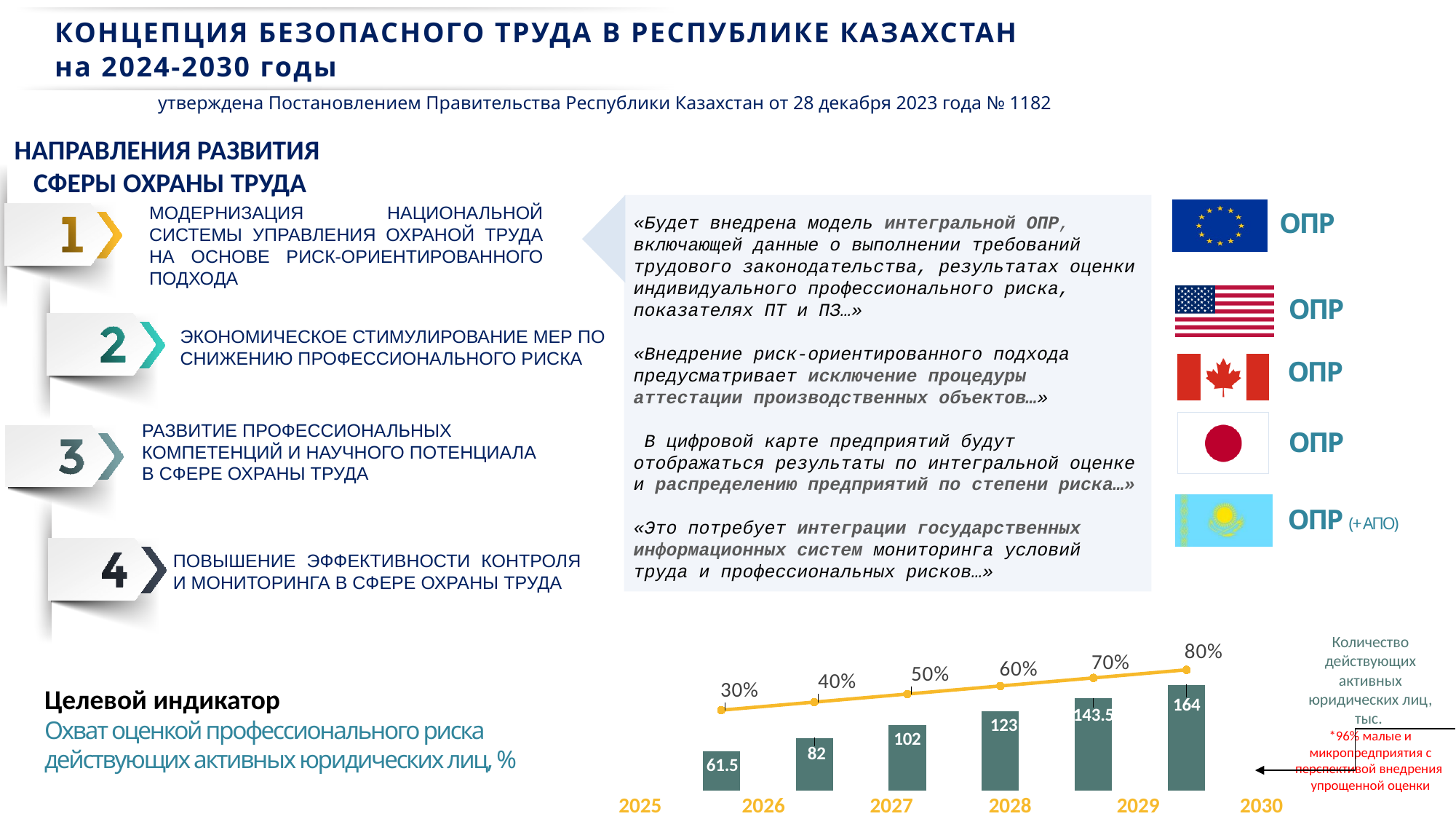
What is the bar value for 2025 in the chart at the bottom of the slide? 61.5 Is the bar value for 2029 larger or smaller than the bar value for 2028 in the chart at the bottom of the slide? larger Which year has the highest bar value in the chart at the bottom of the slide? 2030 Which year has the lowest bar value in the chart at the bottom of the slide? 2025 What is the bar value for 2027 in the chart at the bottom of the slide? 102 Do the bar values rise or fall from 2025 to 2030 in the chart at the bottom of the slide? rise What unit is given for the bar values in the chart at the bottom of the slide, according to the label to the right of the chart? тыс. What percentage does the line show for 2028 in the chart at the bottom of the slide? 60% What is the difference between the line percentages for 2029 and 2026 in the chart at the bottom of the slide? 30% What is the difference between the bar values for 2030 and 2025 in the chart at the bottom of the slide? 102.5 What percentage does the line show for 2030 in the chart at the bottom of the slide? 80% How many years are shown on the x axis of the chart at the bottom of the slide? 6